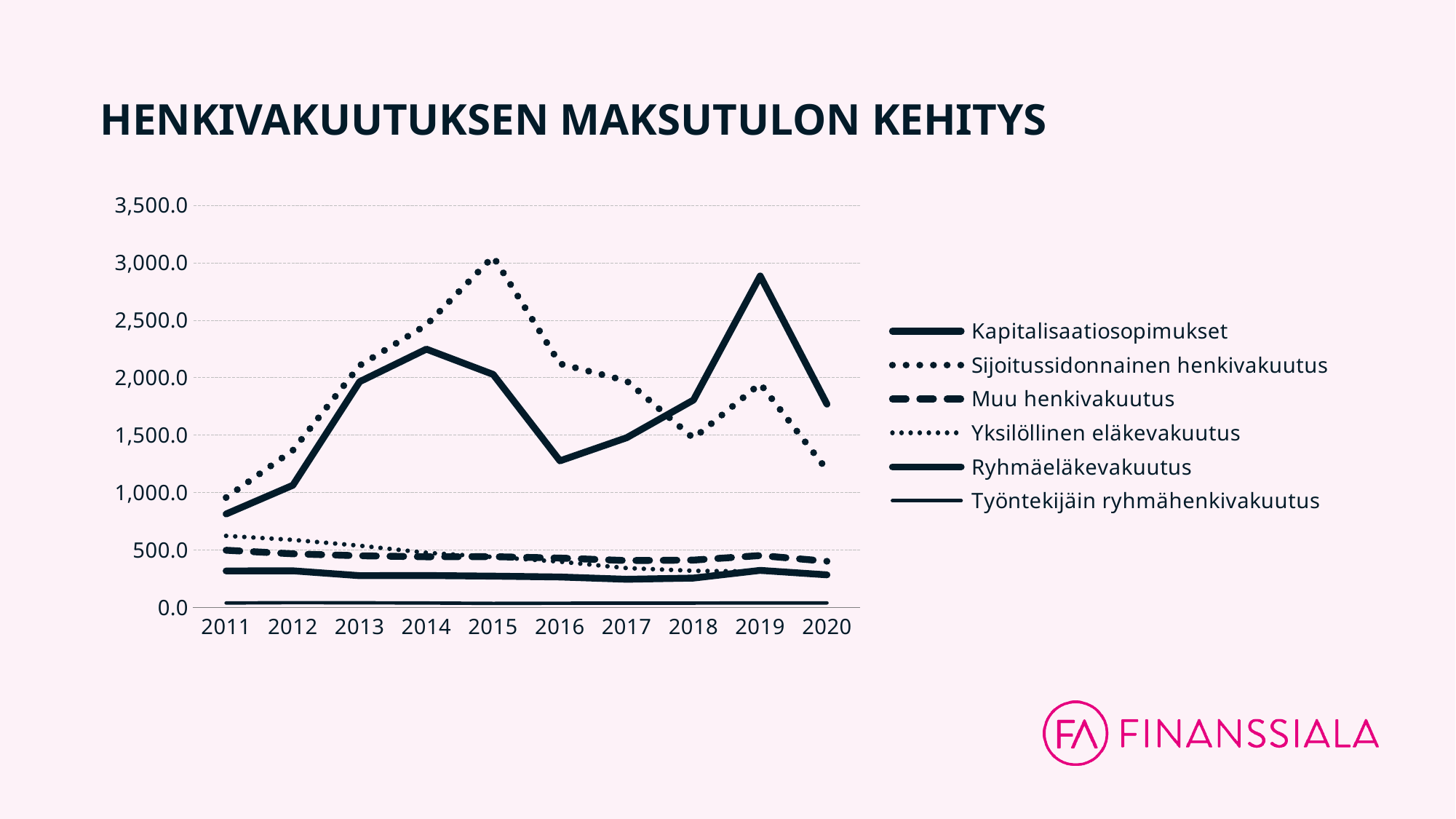
In which year does Kapitalisaatiosopimukset reach its highest value? 2019 Is the value for Kapitalisaatiosopimukset in 2011 greater or less than 1,000.0? less In 2015, which is larger: Sijoitussidonnainen henkivakuutus or Kapitalisaatiosopimukset? Sijoitussidonnainen henkivakuutus What kind of chart is shown on the slide? line chart How many years are shown on the x axis? 10 In 2019, which is larger: Kapitalisaatiosopimukset or Sijoitussidonnainen henkivakuutus? Kapitalisaatiosopimukset Which series has the lowest values across all years? Työntekijäin ryhmähenkivakuutus Does the value for Yksilöllinen eläkevakuutus rise or fall from 2011 to 2020? fall Is the value for Kapitalisaatiosopimukset in 2016 greater or less than 1,500.0? less Is the value for Sijoitussidonnainen henkivakuutus in 2015 greater or less than 2,500.0? greater How many series does the legend list? 6 In which year does Sijoitussidonnainen henkivakuutus reach its highest value? 2015